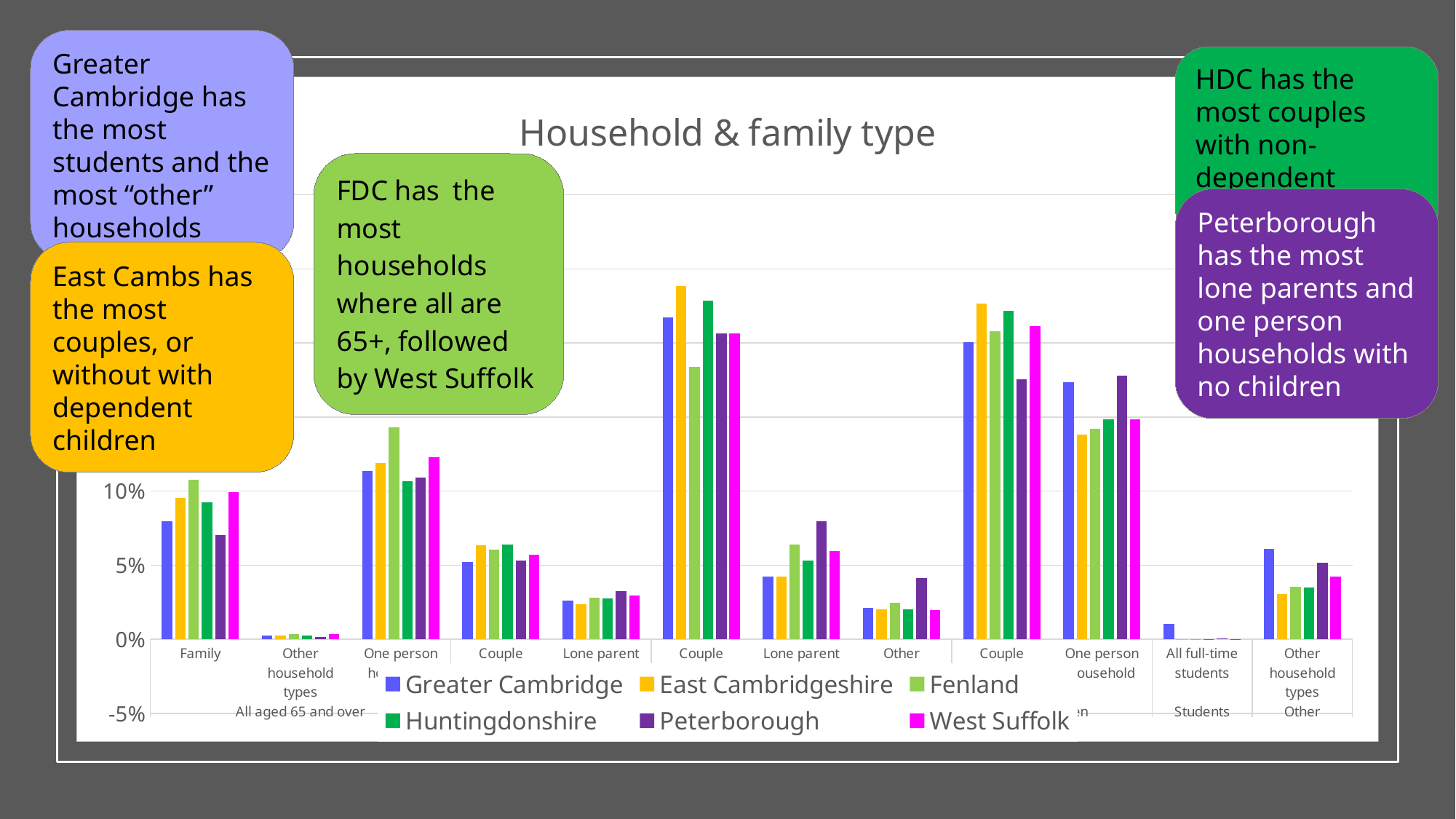
What is the title of the chart? Household & family type How many categories are plotted along the x axis of the chart? 12 Is the value for Fenland in the Family category greater or less than 5%? greater Is the value for Greater Cambridge in the All full-time students category greater or less than 5%? less Is the value for Greater Cambridge in the rightmost Other household types category greater or less than 5%? greater In the second Lone parent category, which is larger: Peterborough or Greater Cambridge? Peterborough In the All full-time students category, which series has the highest value? Greater Cambridge In the Family category, which series has the highest value? Fenland What type of chart is shown on the slide? bar chart How many series does the chart legend list? 6 In the Family category, which series has the lowest value? Peterborough Which series is shown in magenta in the chart legend? West Suffolk